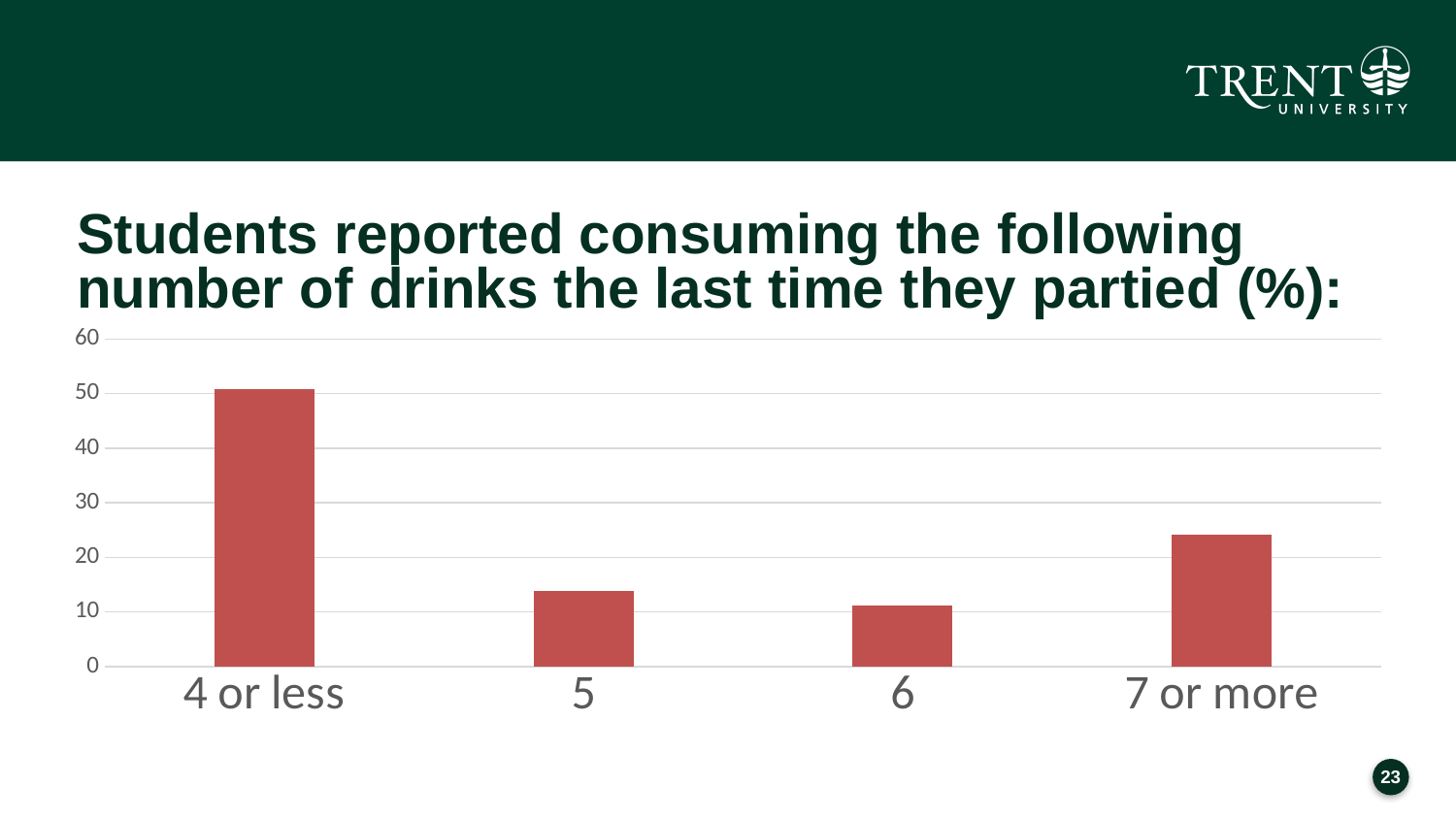
Is the value for "6" greater or less than 20? less Which category has the highest value in the chart? 4 or less Which category has the lowest value in the chart? 6 What colour are the bars in the chart? red Is the value for "4 or less" greater or less than 40? greater Is the value for "7 or more" greater or less than 20? greater Which is larger, the value for "7 or more" or the value for "5"? 7 or more How many categories are shown on the x axis of the chart? 4 What is the title of the chart? Students reported consuming the following number of drinks the last time they partied (%): What kind of chart is shown on the slide? bar chart